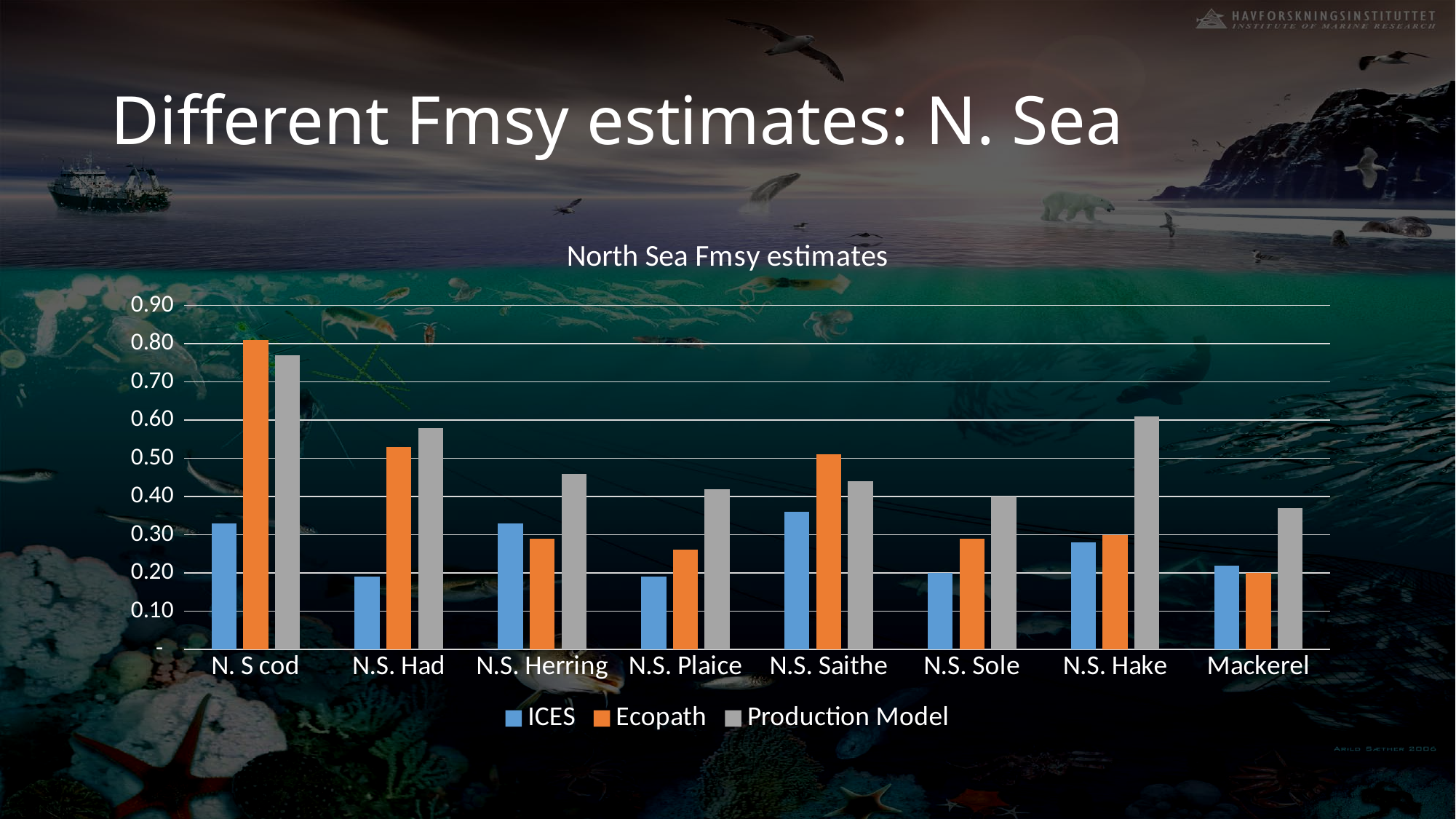
Which category has the highest Production Model value? N. S cod Is the Ecopath value for N. S cod greater or less than 0.70? greater Is the ICES value for N.S. Saithe greater or less than 0.30? greater For N.S. Herring, which is larger: the ICES value or the Ecopath value? ICES What is the title of the chart? North Sea Fmsy estimates How many stock categories are shown on the x axis? 8 Is the Production Model value for N.S. Herring greater or less than 0.40? greater Which category has the highest Ecopath value? N. S cod For N.S. Hake, which is larger: the Ecopath value or the Production Model value? Production Model What kind of chart is shown on the slide? bar chart How many series does the legend list? 3 Which category has the lowest Ecopath value? Mackerel